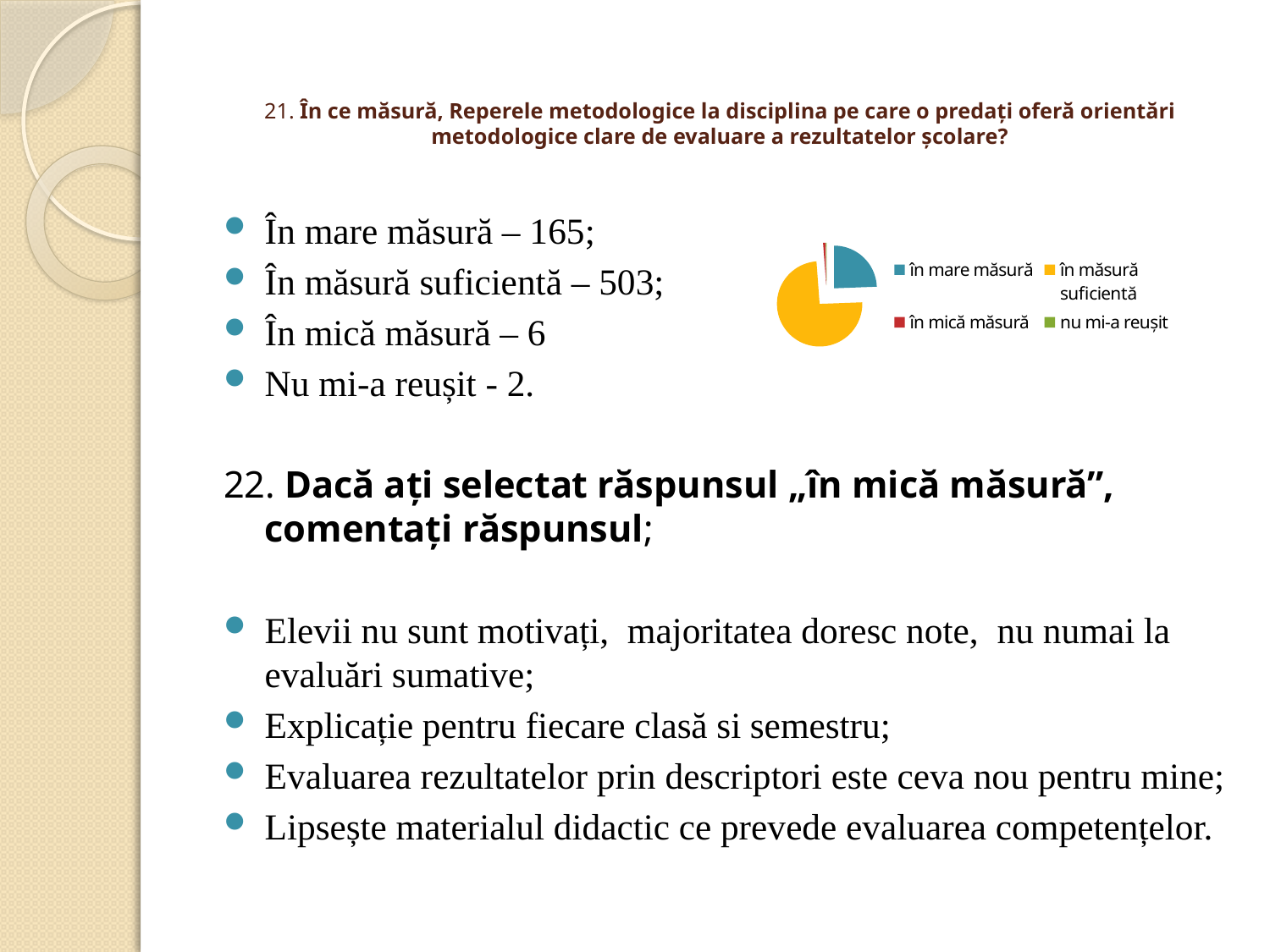
Which category has the smallest slice in the pie chart? nu mi-a reușit What is the difference between the values for 'în măsură suficientă' and 'în mare măsură'? 338 What colour represents 'în mare măsură' in the pie chart? blue Which is larger, the value for 'în mare măsură' or the value for 'în măsură suficientă'? în măsură suficientă According to the slide, what is the value for 'nu mi-a reușit'? 2 What colour represents 'în măsură suficientă' in the pie chart? yellow How many categories does the pie chart's legend list? 4 Which category has the largest slice in the pie chart? în măsură suficientă What kind of chart is shown on the slide? pie chart According to the slide, what is the value for 'în măsură suficientă'? 503 According to the slide, what is the value for 'în mare măsură'? 165 According to the slide, what is the value for 'în mică măsură'? 6